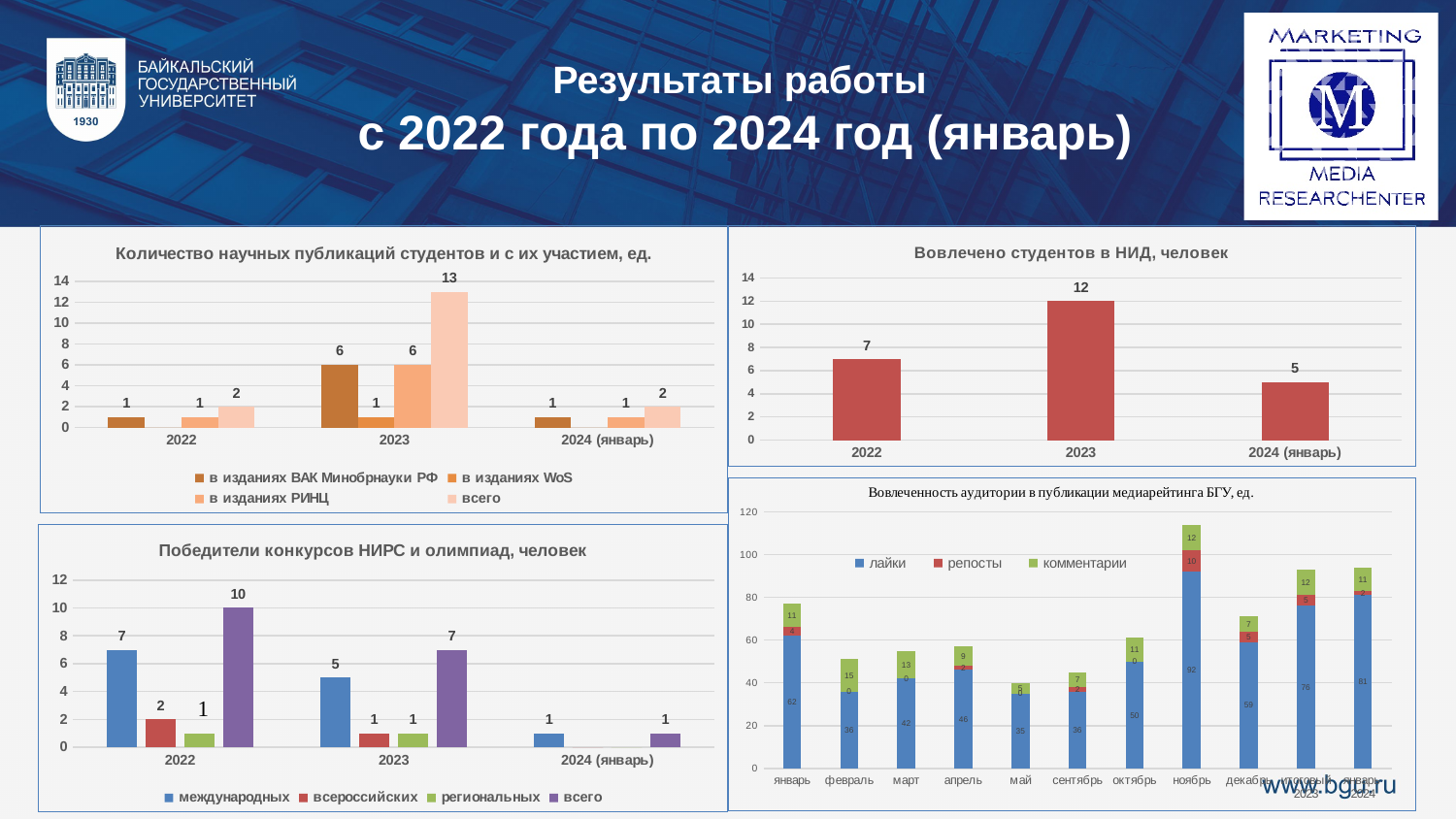
In the chart 'Количество научных публикаций студентов и с их участием, ед.', what is the value of 'в изданиях WoS' for 2023? 1 In the chart 'Вовлечено студентов в НИД, человек', how many categories are shown on the x axis? 3 In the chart 'Вовлечено студентов в НИД, человек', what is the value for 2023? 12 In the chart 'Победители конкурсов НИРС и олимпиад, человек', what is the value of 'всего' for 2022? 10 In the chart 'Победители конкурсов НИРС и олимпиад, человек', which is larger: 'международных' for 2022 or 'международных' for 2023? 2022 In the chart 'Количество научных публикаций студентов и с их участием, ед.', how many series does the legend list? 4 In the chart 'Победители конкурсов НИРС и олимпиад, человек', what is the difference between 'международных' and 'всероссийских' for 2022? 5 In the chart 'Количество научных публикаций студентов и с их участием, ед.', what is the value of 'всего' for 2023? 13 In the chart 'Вовлечено студентов в НИД, человек', which year has the lowest value? 2024 (январь) In the chart 'Вовлеченность аудитории в публикации медиарейтинга БГУ, ед.', which month has the highest total bar? ноябрь What type of chart is 'Вовлеченность аудитории в публикации медиарейтинга БГУ, ед.'? Stacked bar chart In the chart 'Вовлечено студентов в НИД, человек', what is the difference between the values for 2023 and 2022? 5